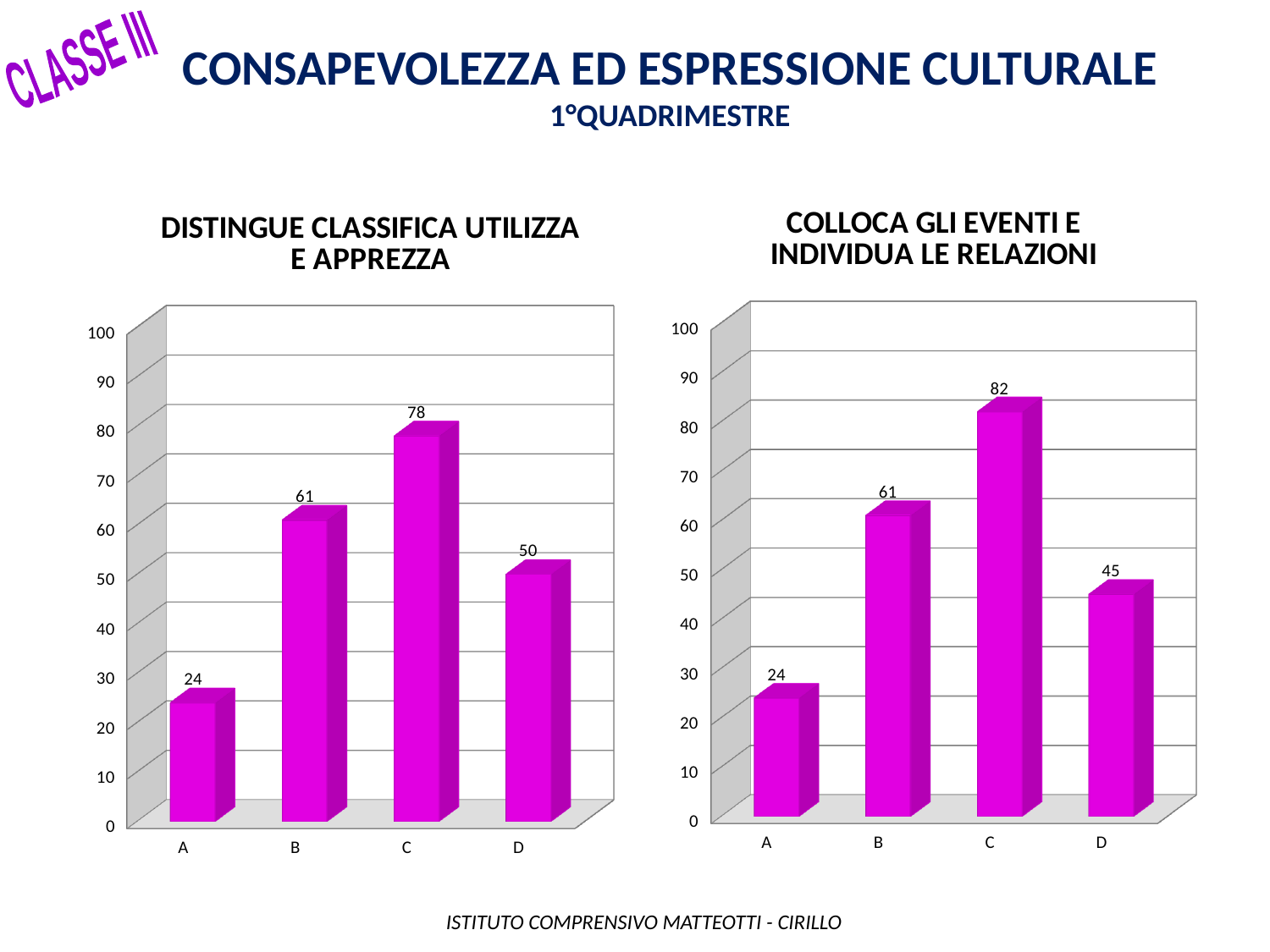
In the chart titled "DISTINGUE CLASSIFICA UTILIZZA E APPREZZA", what is the difference between the values for C and D? 28 In the chart titled "DISTINGUE CLASSIFICA UTILIZZA E APPREZZA", what is the value for category C? 78 In the chart titled "COLLOCA GLI EVENTI E INDIVIDUA LE RELAZIONI", which category has the highest value? C In the chart titled "DISTINGUE CLASSIFICA UTILIZZA E APPREZZA", is the value for B greater or less than 50? greater In the chart titled "COLLOCA GLI EVENTI E INDIVIDUA LE RELAZIONI", what is the difference between the values for C and A? 58 What kind of chart is the chart titled "DISTINGUE CLASSIFICA UTILIZZA E APPREZZA"? Bar chart How many categories are shown in the chart titled "COLLOCA GLI EVENTI E INDIVIDUA LE RELAZIONI"? 4 In the chart titled "DISTINGUE CLASSIFICA UTILIZZA E APPREZZA", which category has the lowest value? A In the chart titled "DISTINGUE CLASSIFICA UTILIZZA E APPREZZA", what is the value for category A? 24 What is the title of the chart on the right side of the slide? COLLOCA GLI EVENTI E INDIVIDUA LE RELAZIONI In the chart titled "COLLOCA GLI EVENTI E INDIVIDUA LE RELAZIONI", which is larger, the value for B or the value for D? B In the chart titled "COLLOCA GLI EVENTI E INDIVIDUA LE RELAZIONI", what is the value for category D? 45